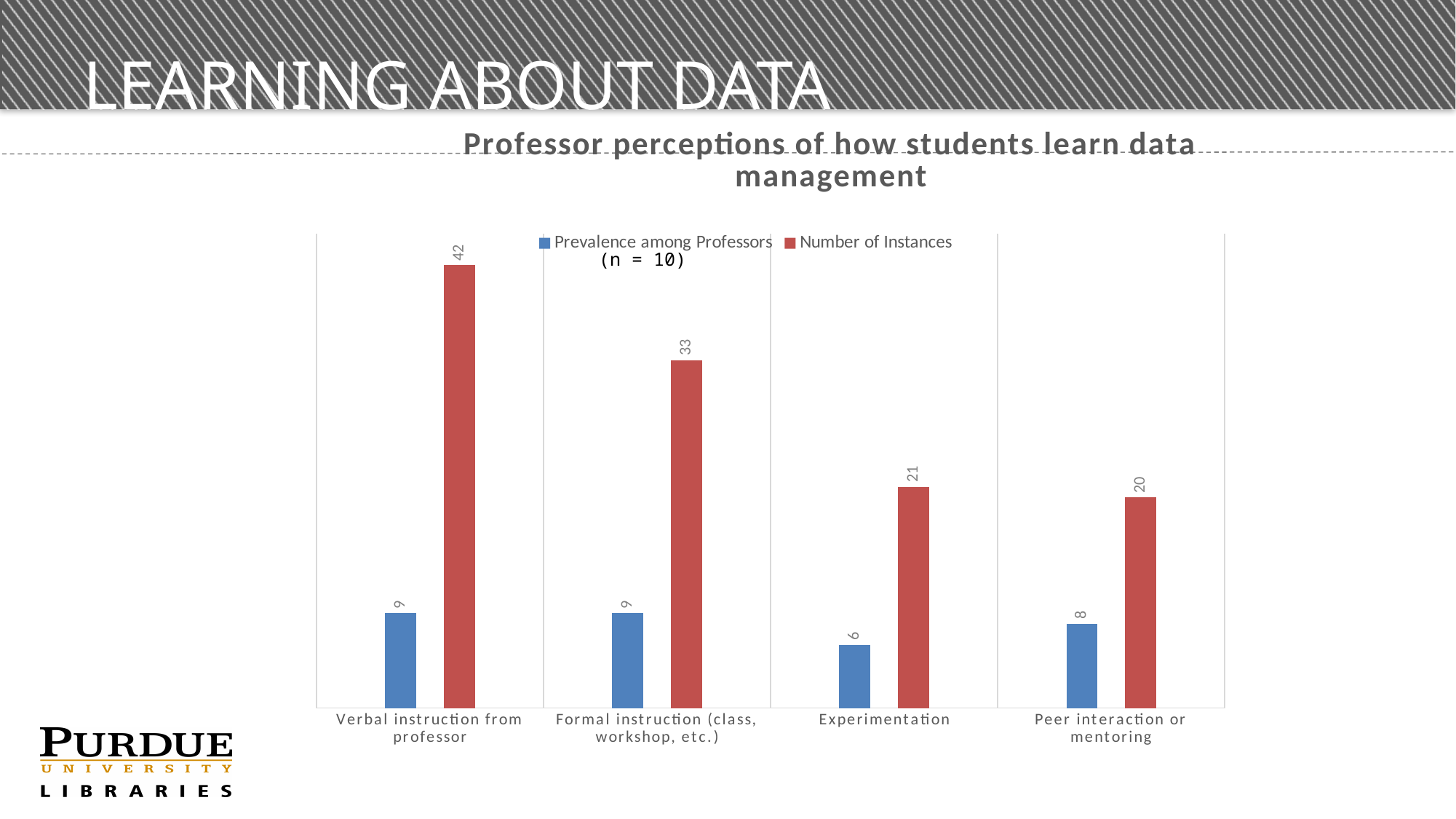
What is the Prevalence among Professors for Experimentation? 6 Which category has the lowest Prevalence among Professors? Experimentation Which has a higher Number of Instances, Experimentation or Peer interaction or mentoring? Experimentation What is the difference in Number of Instances between Verbal instruction from professor and Formal instruction (class, workshop, etc.)? 9 What kind of chart is shown on the slide? Bar chart How many categories are shown on the x axis? 4 How many series does the legend list? 2 Do the Number of Instances values rise or fall from Verbal instruction from professor to Experimentation? Fall What is the Number of Instances for Verbal instruction from professor? 42 What is the Number of Instances for Peer interaction or mentoring? 20 Which category has the highest Number of Instances? Verbal instruction from professor What is the title of the chart? Professor perceptions of how students learn data management